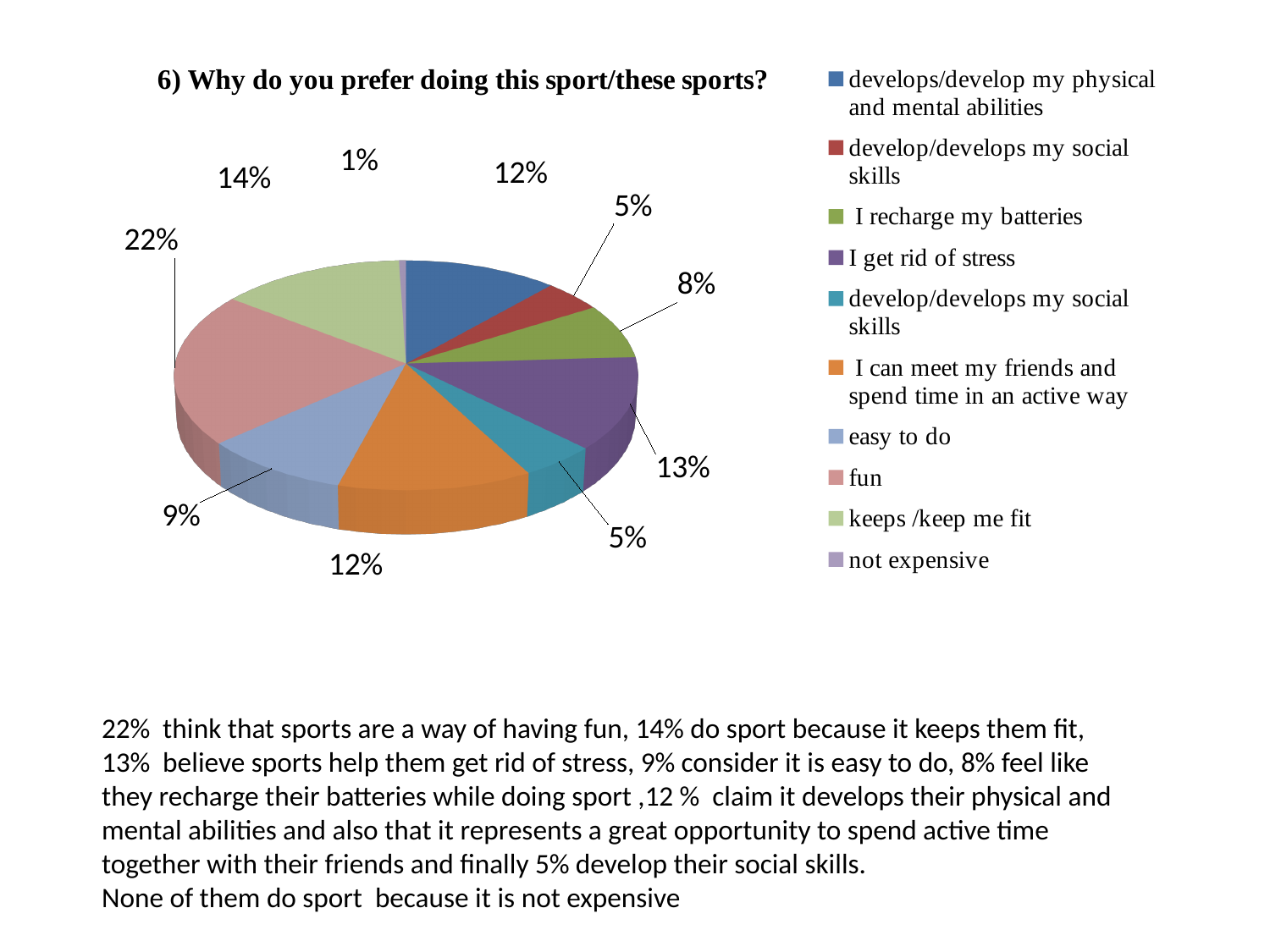
Which reason has the smallest slice of the pie? not expensive What percentage is shown for "I get rid of stress"? 13% How many percentage points larger is the "fun" slice than the "keeps /keep me fit" slice? 8 percentage points How many entries does the legend list? 10 Which is larger, the slice for "I get rid of stress" or the slice for "easy to do"? I get rid of stress What percentage is shown for "easy to do"? 9% What percentage is shown for "I recharge my batteries"? 8% What kind of chart is shown on the slide? Pie chart What percentage is shown for "keeps /keep me fit"? 14% What share of the pie is labelled "fun"? 22% Which reason has the largest slice of the pie? fun What percentage is shown for "not expensive"? 1%